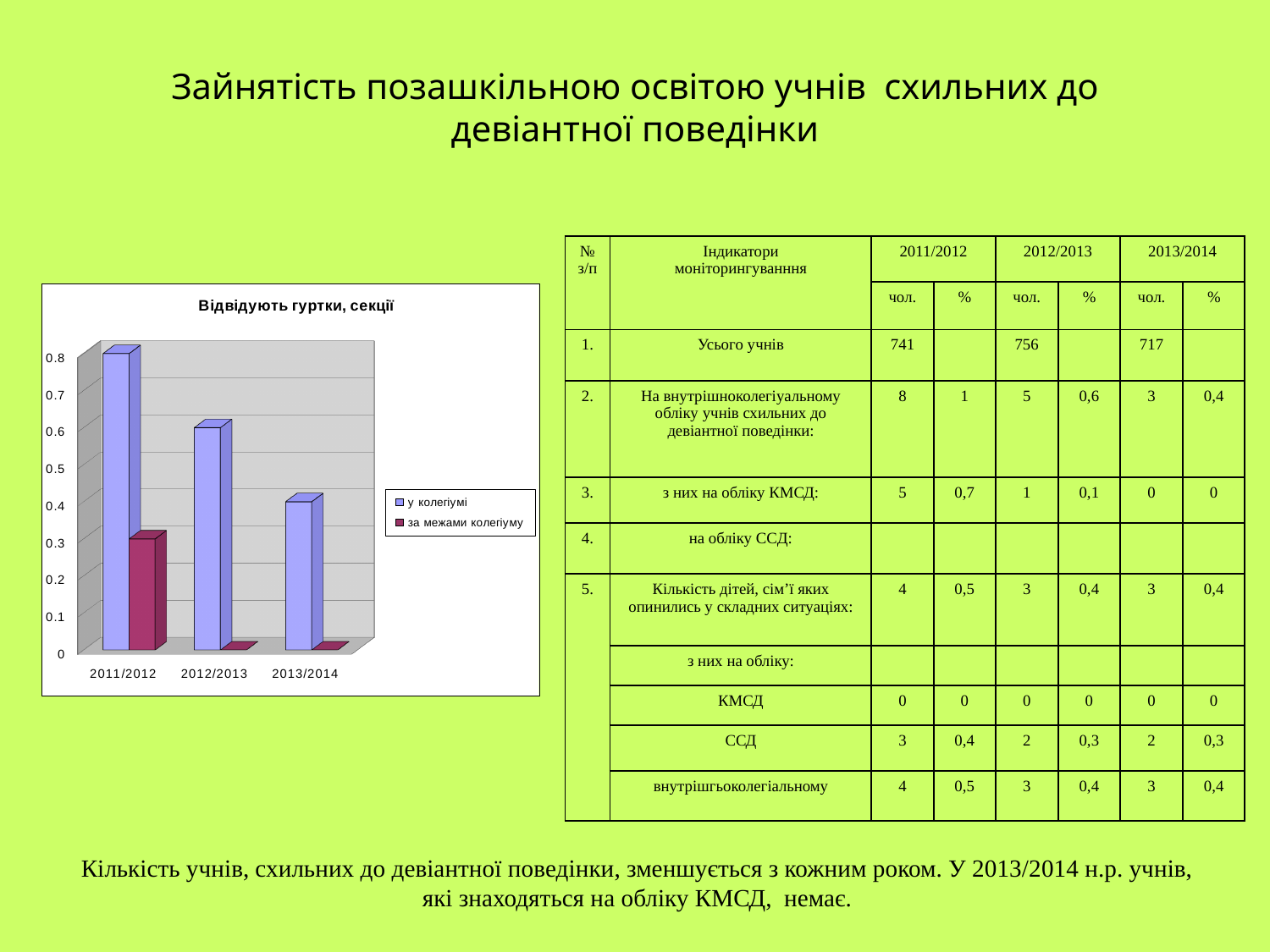
Is the value for "за межами колегіуму" in 2011/2012 greater or less than 0.2? greater In 2011/2012, which series has the larger value: "у колегіумі" or "за межами колегіуму"? у колегіумі In which school year is the value for "у колегіумі" highest? 2011/2012 Do the values for "у колегіумі" rise or fall from 2011/2012 to 2013/2014? fall What is the title of the chart? Відвідують гуртки, секції Is the value for "у колегіумі" in 2011/2012 greater or less than 0.7? greater Is the value for "у колегіумі" in 2013/2014 greater or less than 0.5? less What kind of chart is shown on the slide? bar chart In which school year is the value for "у колегіумі" lowest? 2013/2014 How many series does the legend of the chart list? 2 How many school years are shown on the x axis of the chart? 3 Which colour represents the series "у колегіумі" in the chart? blue